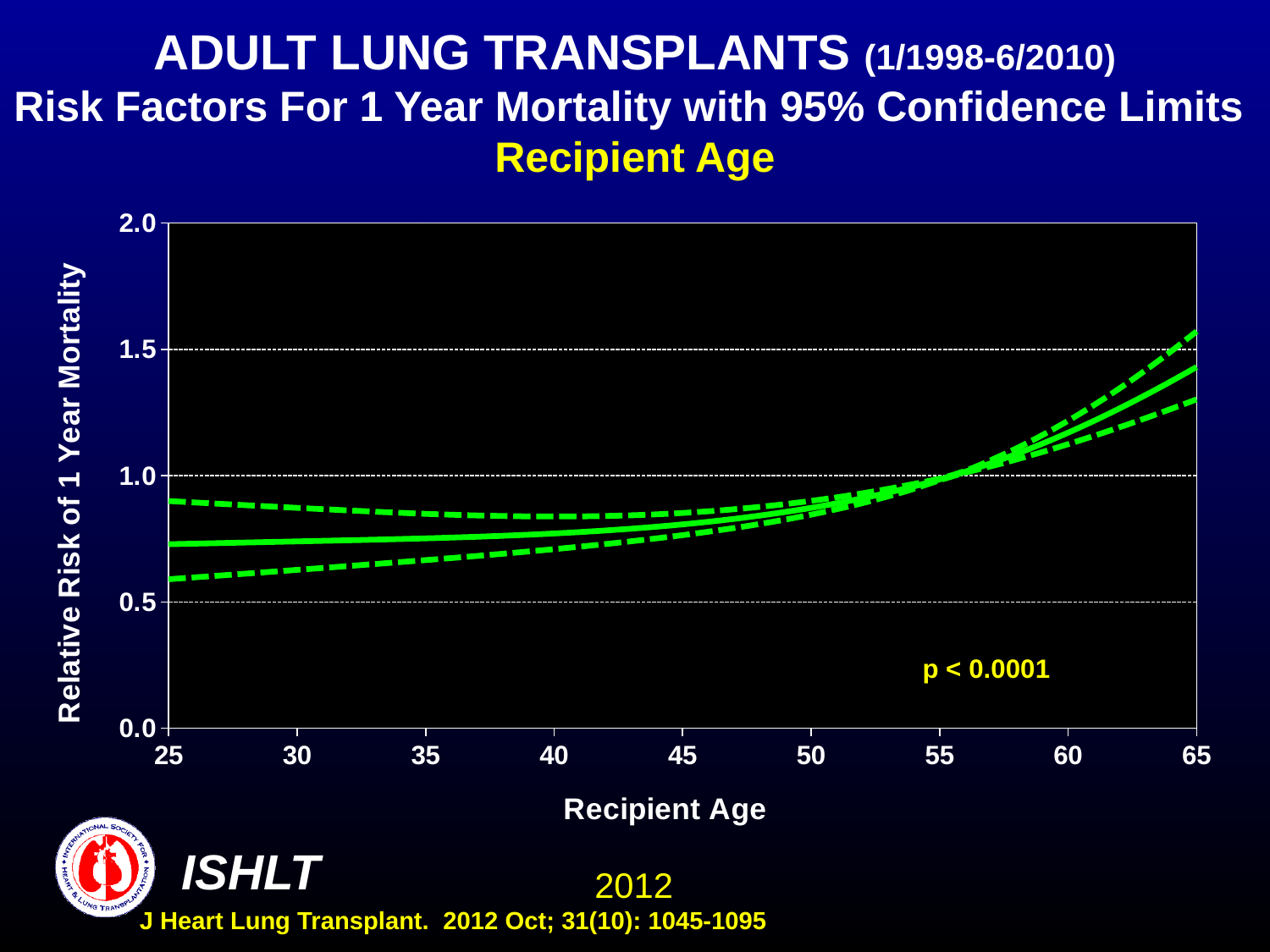
How many lines are plotted on the chart? 3 Is the relative risk of 1 year mortality (solid line) at recipient age 65 greater or less than 1.0? greater Does the relative risk of 1 year mortality rise or fall as recipient age increases from 25 to 65? rise At which recipient age shown on the x axis is the relative risk of 1 year mortality lowest? 25 Is the relative risk of 1 year mortality (solid line) at recipient age 25 greater or less than 1.0? less At which recipient age shown on the x axis is the relative risk of 1 year mortality highest? 65 Is the upper 95% confidence limit (upper dashed line) at recipient age 25 greater or less than 1.0? less What is the p-value shown on the chart? p < 0.0001 What is the label of the y axis? Relative Risk of 1 Year Mortality What type of chart is shown on the slide? line chart